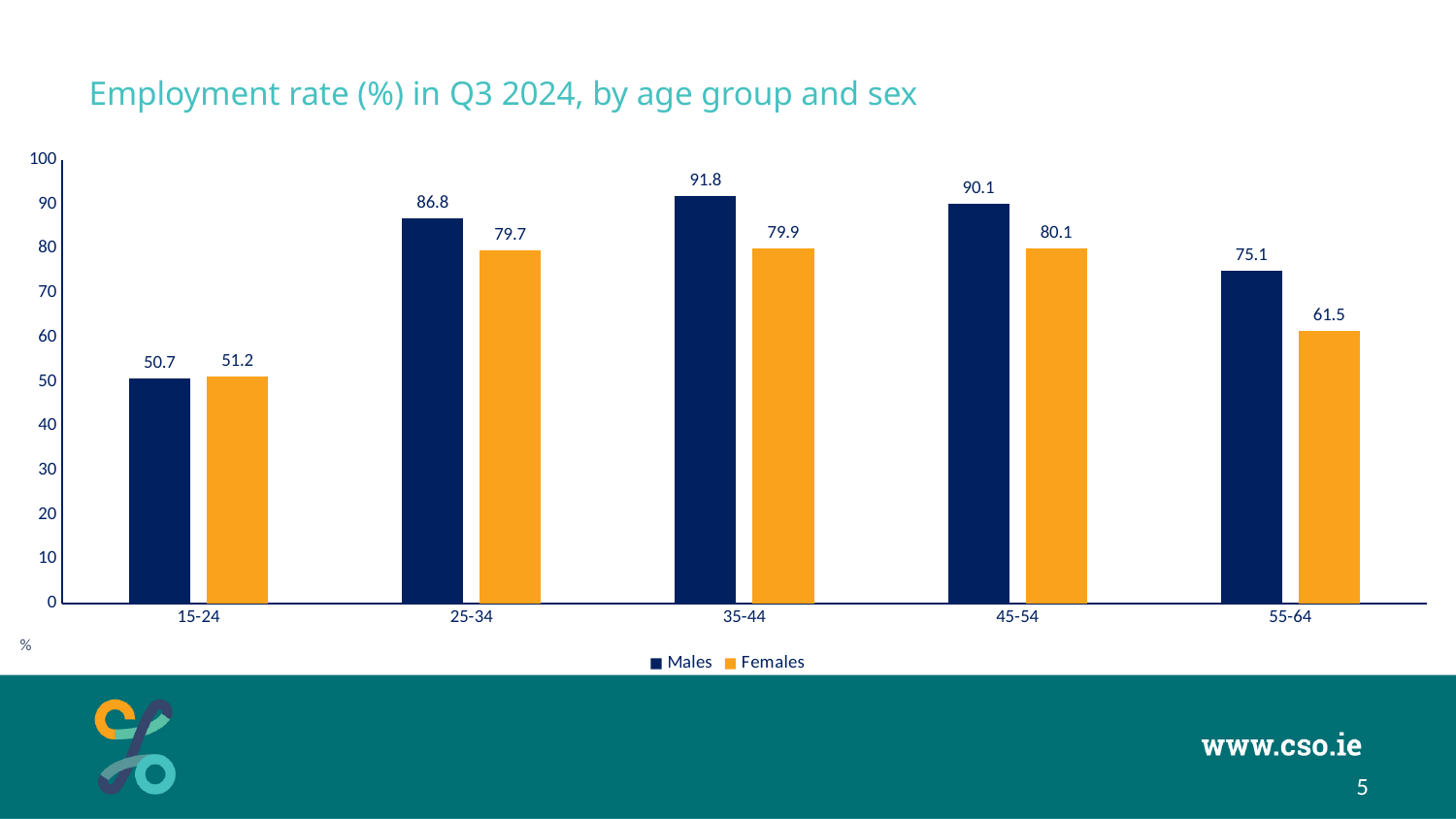
What type of chart is shown on the slide? Bar chart How many age groups are shown on the x axis? 5 Which age group has the highest employment rate for males? 35-44 What is the difference between the male and female employment rates in the 55-64 age group? 13.6 Is the employment rate for males aged 55-64 greater or less than 70? greater What is the employment rate for males aged 35-44? 91.8 What colour represents Females in the chart? Orange What is the employment rate for females aged 55-64? 61.5 Which age group has the lowest employment rate for females? 15-24 What is the employment rate for females aged 15-24? 51.2 How many series does the legend list? 2 In the 15-24 age group, is the employment rate higher for males or females? Females